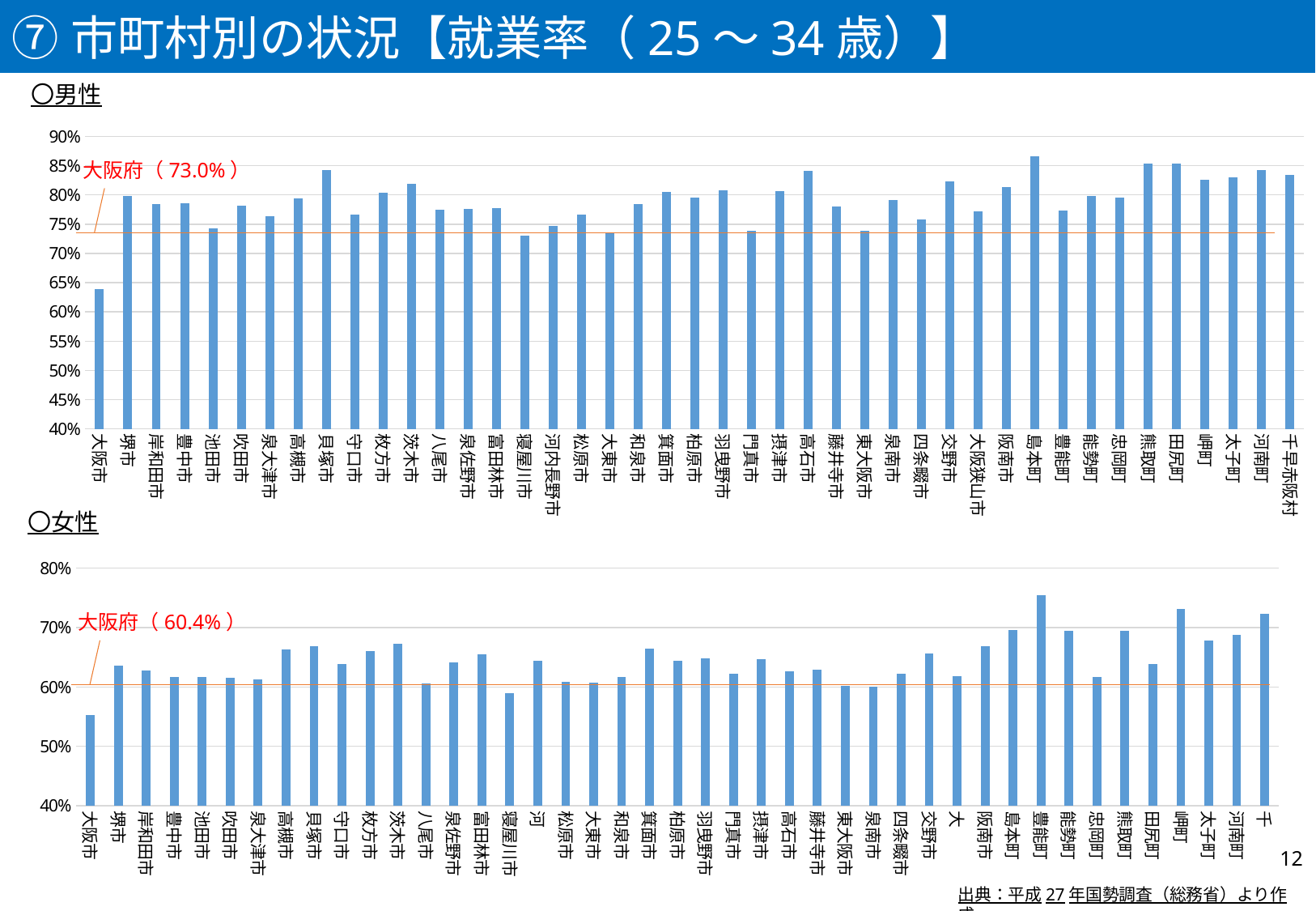
In the 男性 chart, is the value for 大阪市 greater or less than 70%? less What kind of chart is the 男性 chart? bar chart In the 男性 chart, is the value for 島本町 greater or less than 85%? greater In the 男性 chart, which is larger, 貝塚市 or 守口市? 貝塚市 In the 男性 chart, what is the 大阪府 reference value shown in red? 73.0% In the 男性 chart, which municipality has the lowest employment rate? 大阪市 In the 女性 chart, which municipality has the lowest employment rate? 大阪市 In the 女性 chart, what is the 大阪府 reference value shown in red? 60.4% In the 男性 chart, which municipality has the highest employment rate? 島本町 In the 女性 chart, which is larger, 豊能町 or 島本町? 豊能町 In the 女性 chart, is the value for 岬町 greater or less than 70%? greater In the 女性 chart, which municipality has the highest employment rate? 豊能町